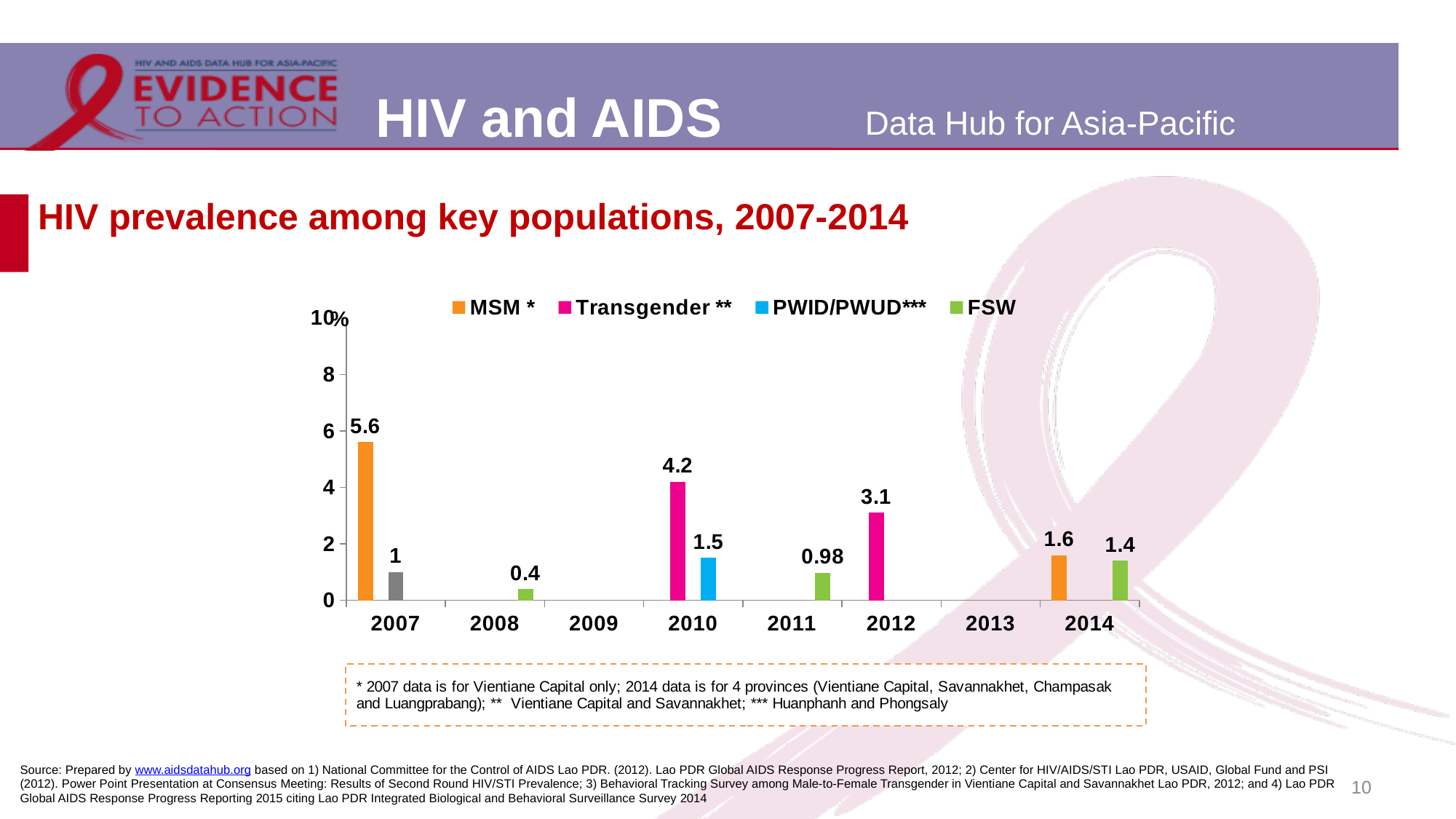
What is the HIV prevalence among FSW in 2011? 0.98 What kind of chart is shown on the slide? Bar chart What is the HIV prevalence among PWID/PWUD in 2010? 1.5 Does the Transgender value rise or fall from 2010 to 2012? Fall What is the HIV prevalence among Transgender in 2010? 4.2 How many series does the legend list? 4 What is the HIV prevalence among FSW in 2014? 1.4 Which series and year has the highest HIV prevalence value on the chart? MSM in 2007 How many years are shown on the x axis? 8 What is the HIV prevalence among MSM in 2007? 5.6 In 2014, which is larger, the MSM value or the FSW value? MSM What is the difference between the Transgender values in 2010 and 2012? 1.1